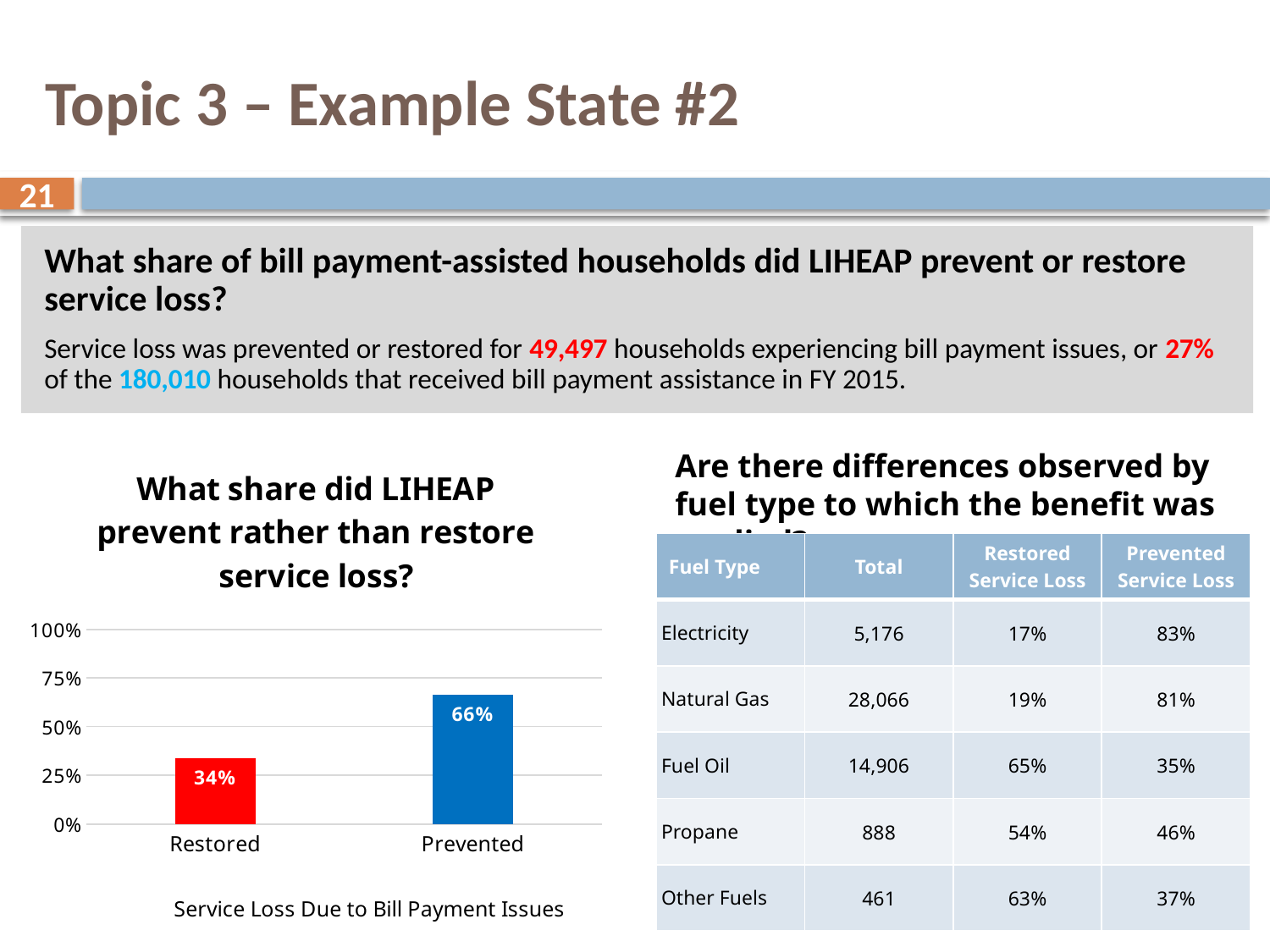
Is the value for Restored greater or less than 50%? less Is the value for Prevented greater or less than 50%? greater What is the value for Restored in the bar chart? 34% What is the value for Prevented in the bar chart? 66% Which category has the lowest value in the bar chart? Restored What colour is the Restored bar in the bar chart? red Which is larger in the bar chart, Restored or Prevented? Prevented What is the title of the bar chart? What share did LIHEAP prevent rather than restore service loss? How many categories are shown in the bar chart? 2 What kind of chart is shown on the slide? bar chart What is the difference between the Prevented and Restored values in the bar chart? 32% Which category has the highest value in the bar chart? Prevented